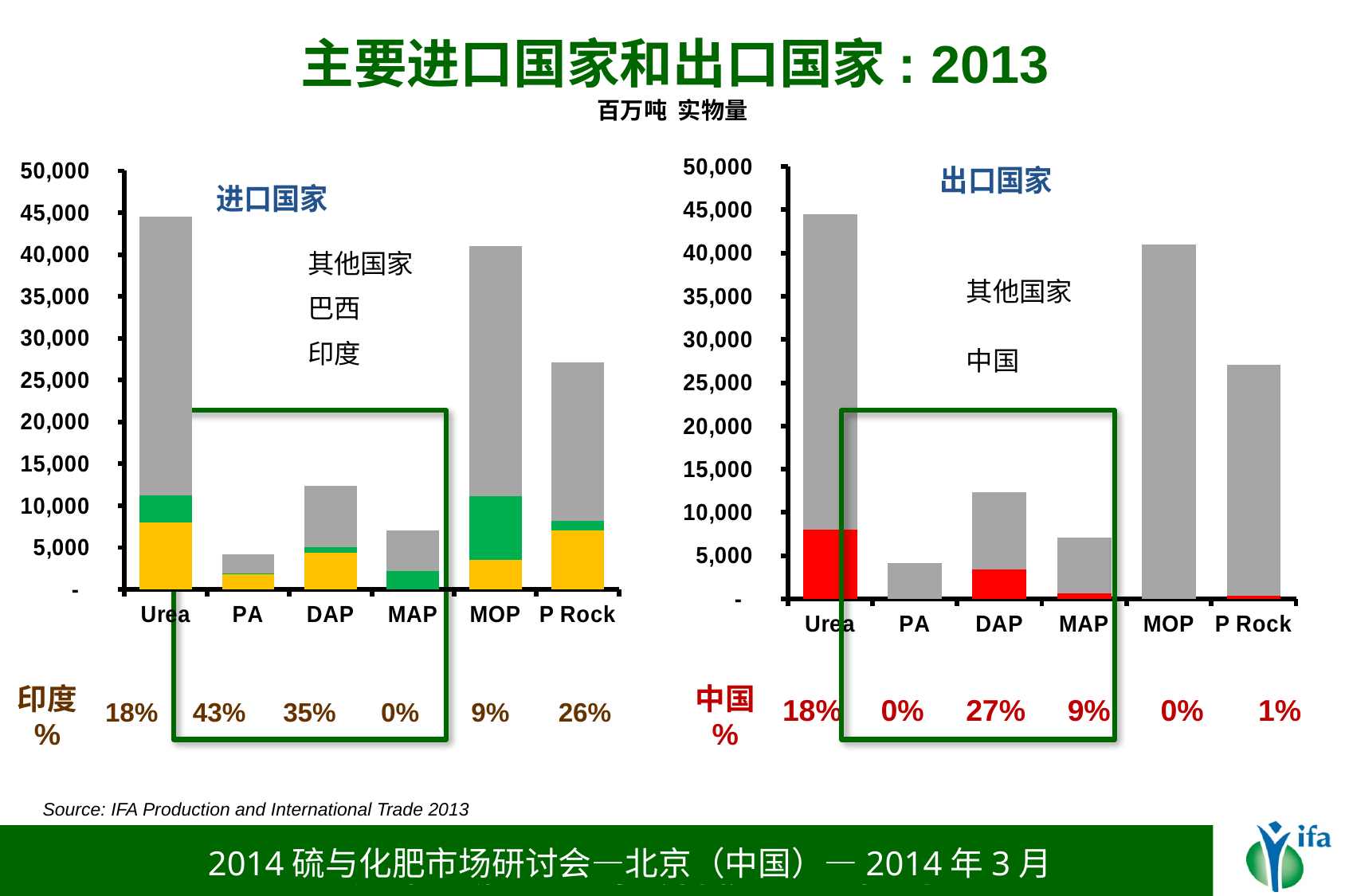
How many series does the legend of the 出口国家 chart on the right list? 2 In the 进口国家 chart on the left, which category has the tallest total bar? Urea In the 出口国家 chart on the right, is the total bar for MAP greater or less than 10,000? less In the 中国 % row under the right chart, what is the percentage shown for DAP? 27% In the 出口国家 chart on the right, which category has the shortest total bar? PA In the 印度 % row under the left chart, what is the percentage shown for PA? 43% In the 进口国家 chart on the left, is the total bar for MOP greater or less than 40,000? greater In the 出口国家 chart on the right, which total bar is taller, Urea or P Rock? Urea Which series in the 出口国家 chart on the right is shown in red? 中国 How many series does the legend of the 进口国家 chart on the left list? 3 How many product categories are shown on the x axis of the 出口国家 chart on the right? 6 What kind of chart is the 进口国家 chart on the left? stacked bar chart